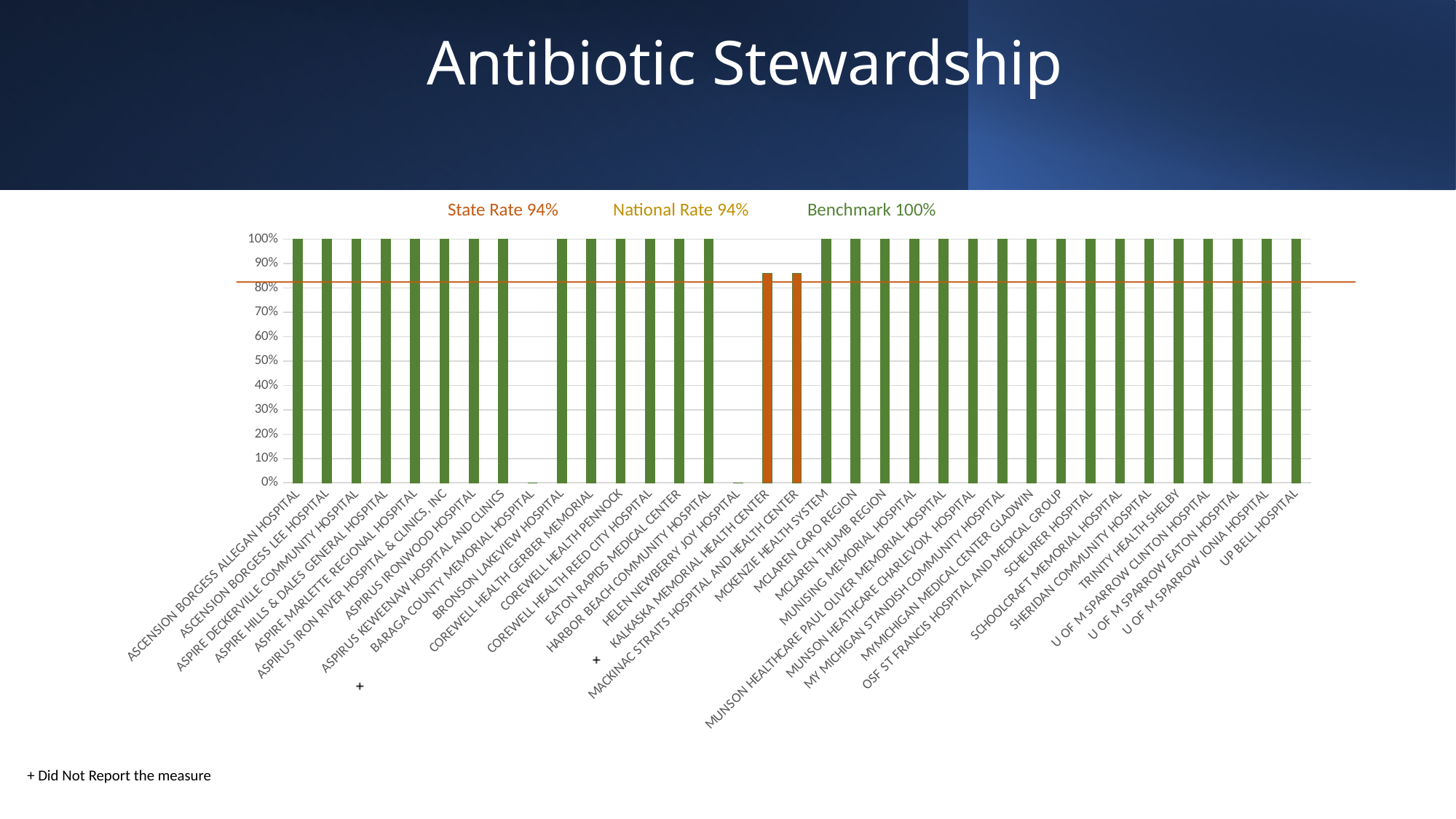
What kind of chart is shown on the slide? bar chart Is the value for Mackinac Straits Hospital and Health Center greater or less than 80%? greater What is the value for UP Bell Hospital? 100% What is the Benchmark value shown above the chart? 100% Which is larger, the value for Kalkaska Memorial Health Center or the value for McKenzie Health System? McKenzie Health System What is the State Rate shown above the chart? 94% Is the value for Kalkaska Memorial Health Center greater or less than 90%? less Which two hospitals are shown with orange bars instead of green? Kalkaska Memorial Health Center and Mackinac Straits Hospital and Health Center According to the footnote, what does the + symbol indicate? Did Not Report the measure What is the value for Ascension Borgess Allegan Hospital? 100% What is the National Rate shown above the chart? 94% How many hospitals are marked with a + as not having reported the measure? 2